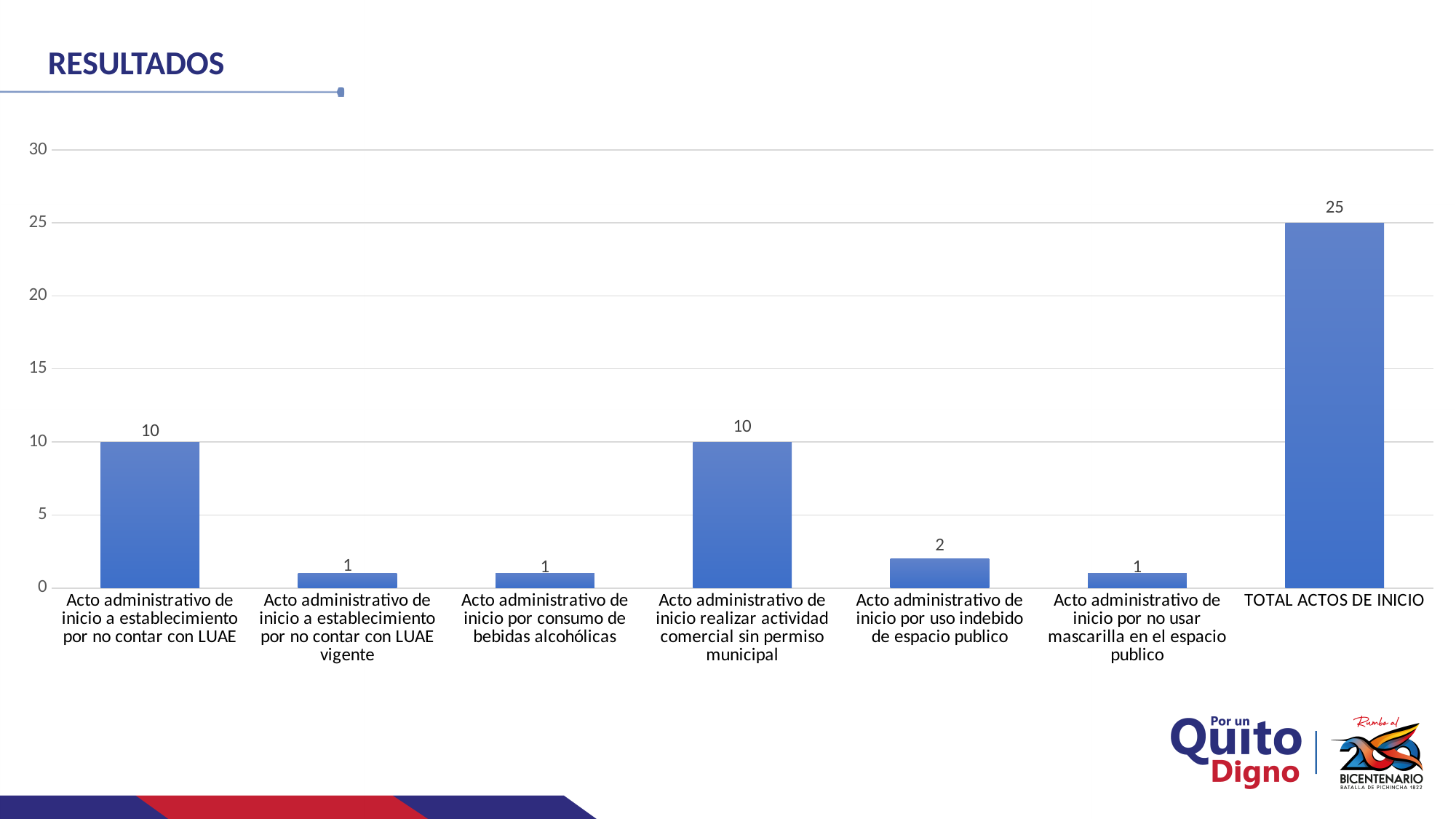
What is the difference between 'TOTAL ACTOS DE INICIO' and 'Acto administrativo de inicio a establecimiento por no contar con LUAE'? 15 Which is larger: 'Acto administrativo de inicio por uso indebido de espacio publico' or 'Acto administrativo de inicio a establecimiento por no contar con LUAE vigente'? Acto administrativo de inicio por uso indebido de espacio publico Which category has the highest value? TOTAL ACTOS DE INICIO What is the value for 'Acto administrativo de inicio por uso indebido de espacio publico'? 2 What is the value for 'TOTAL ACTOS DE INICIO'? 25 What is the value for 'Acto administrativo de inicio por consumo de bebidas alcohólicas'? 1 How many categories are shown on the x axis? 7 What is the difference between 'Acto administrativo de inicio por uso indebido de espacio publico' and 'Acto administrativo de inicio por no usar mascarilla en el espacio publico'? 1 What is the value for 'Acto administrativo de inicio realizar actividad comercial sin permiso municipal'? 10 Is the value for 'TOTAL ACTOS DE INICIO' greater or less than 20? greater What kind of chart is shown on the slide? bar chart What is the title of the slide containing the chart? RESULTADOS